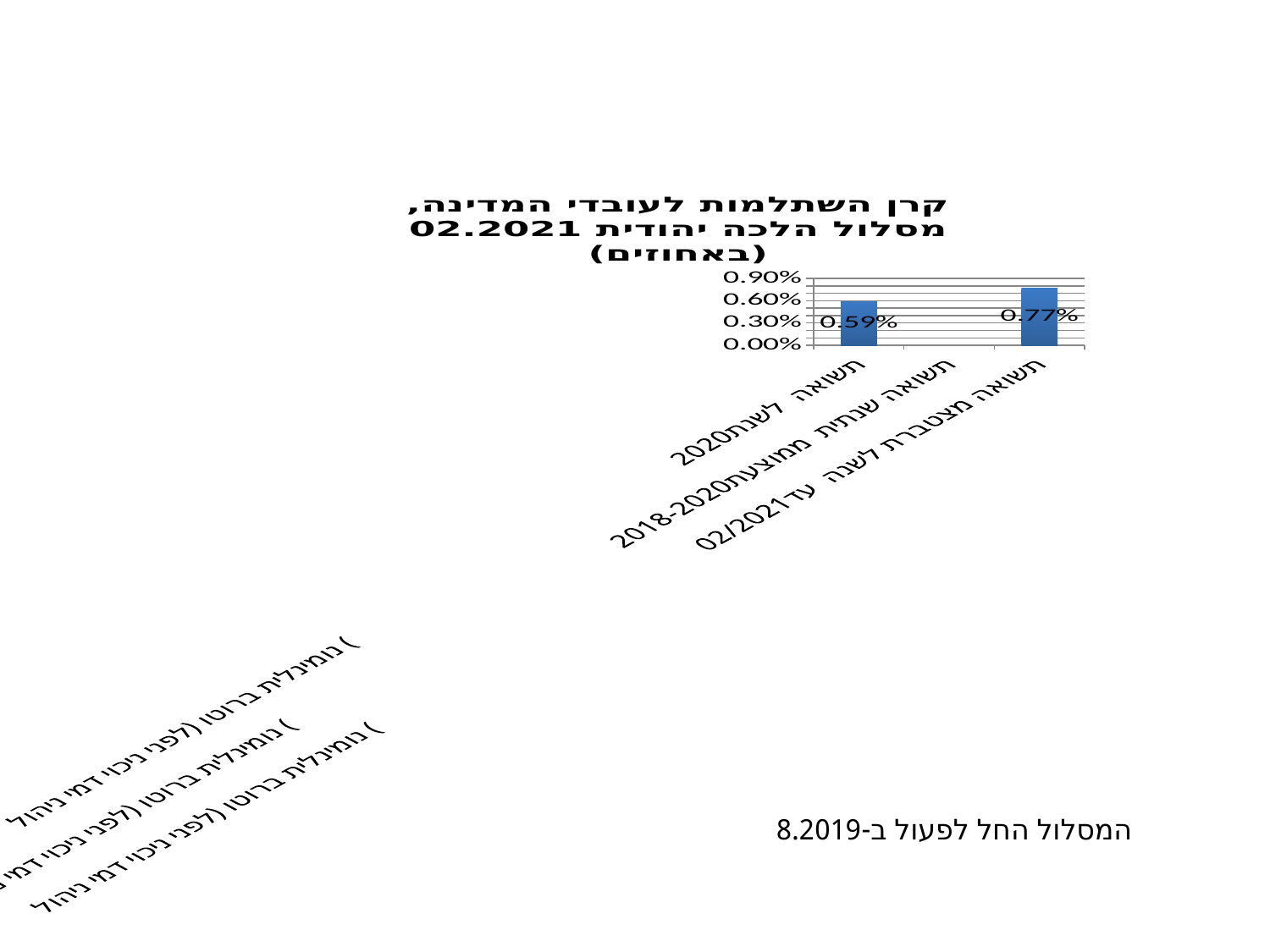
What is the highest value shown on the y axis of the chart? 0.90% What is the value for "תשואה מצטברת לשנה עד 02/2021"? 0.77% What is the difference between the value for "תשואה מצטברת לשנה עד 02/2021" and the value for "תשואה לשנת 2020"? 0.18% Which is larger: the value for "תשואה לשנת 2020" or the value for "תשואה מצטברת לשנה עד 02/2021"? תשואה מצטברת לשנה עד 02/2021 How many categories are shown on the x axis of the chart? 3 What is the value for "תשואה לשנת 2020"? 0.59% Which category on the x axis has no bar plotted? תשואה שנתית ממוצעת 2018-2020 Is the value for "תשואה לשנת 2020" greater or less than 0.60%? less Which category has the highest value? תשואה מצטברת לשנה עד 02/2021 Is the value for "תשואה מצטברת לשנה עד 02/2021" greater or less than 0.60%? greater What kind of chart is shown on the slide? bar chart